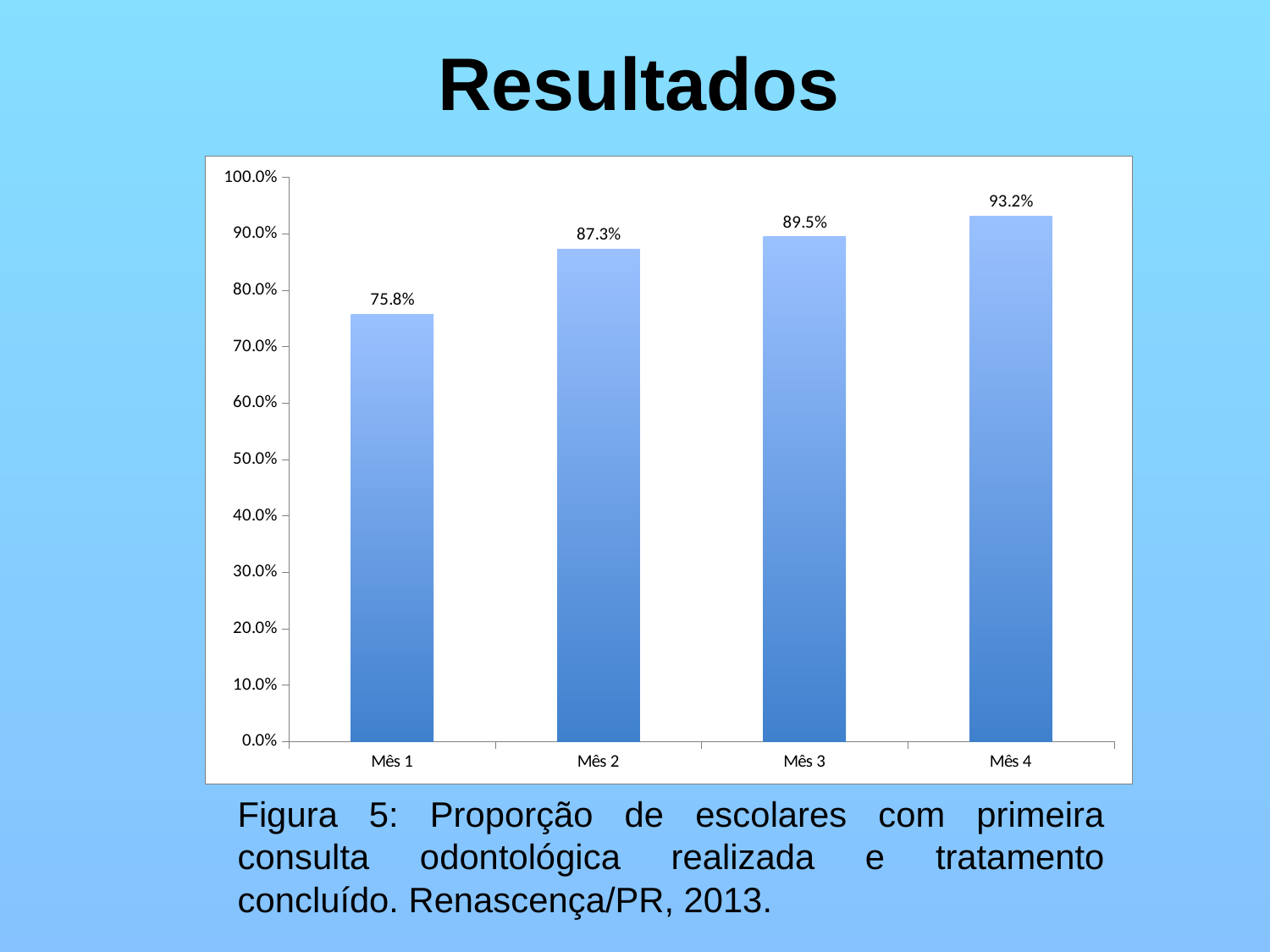
What is the difference between the values for Mês 2 and Mês 1? 11.5% Which is larger, the value for Mês 2 or the value for Mês 3? Mês 3 Do the values rise or fall from Mês 1 to Mês 4? Rise What kind of chart is shown on the slide? Bar chart What is the value for Mês 2? 87.3% Which month has the highest value? Mês 4 What is the difference between the values for Mês 4 and Mês 1? 17.4% What is the value for Mês 4? 93.2% What is the value for Mês 1? 75.8% Which month has the lowest value? Mês 1 How many months are shown on the x axis? 4 What is the value for Mês 3? 89.5%